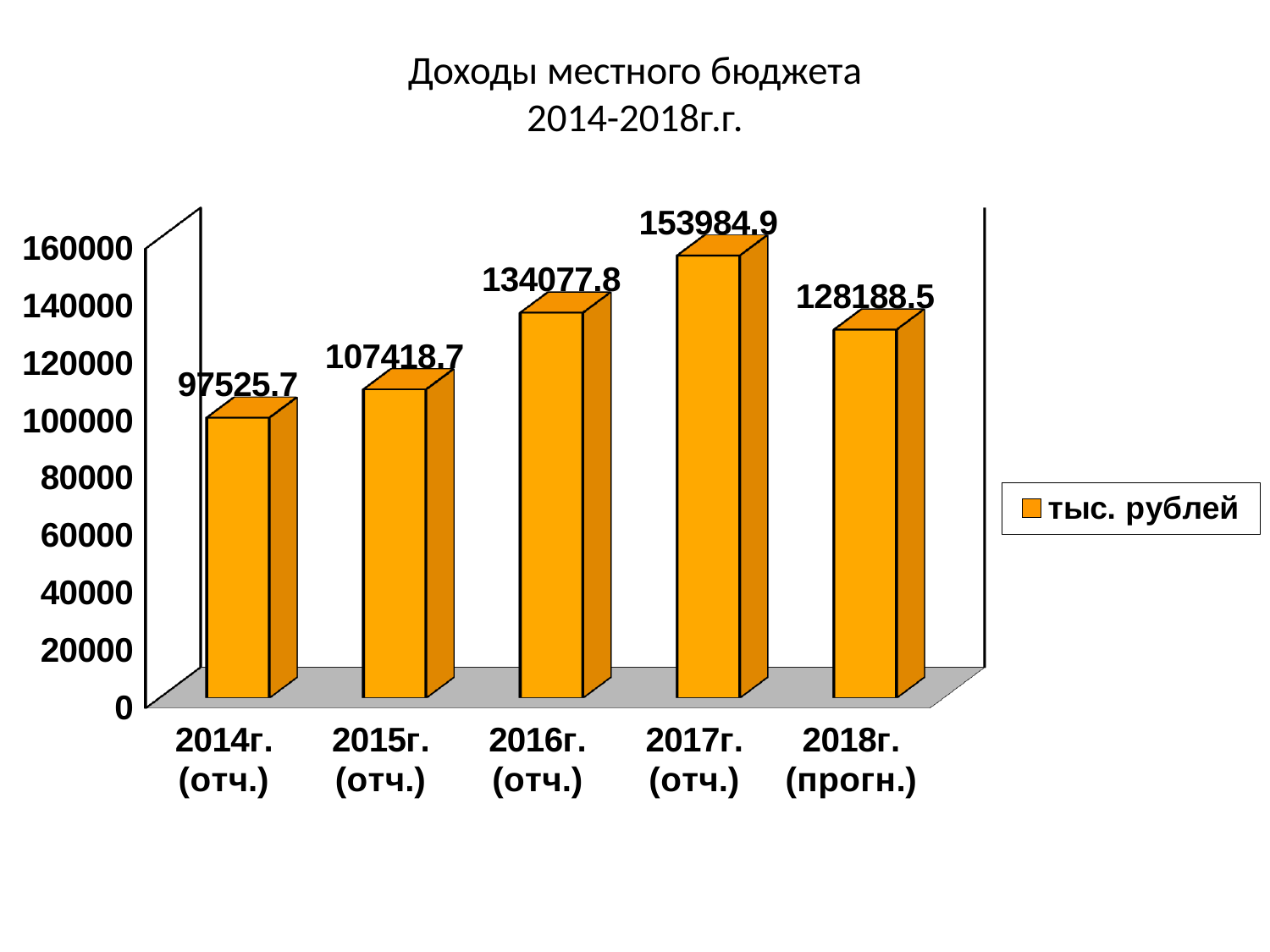
What is the difference between the values for 2017г. (отч.) and 2018г. (прогн.)? 25796.4 What kind of chart is shown on the slide? bar chart Which year has the lowest value? 2014г. (отч.) What is the value for 2017г. (отч.)? 153984.9 How many series does the legend list? 1 What is the value for 2014г. (отч.)? 97525.7 What is the value for 2018г. (прогн.)? 128188.5 What is the legend entry of the chart? тыс. рублей How many categories are shown on the x axis? 5 What is the difference between the values for 2015г. (отч.) and 2014г. (отч.)? 9893.0 Which year has the highest value? 2017г. (отч.) Which is larger, the value for 2016г. (отч.) or the value for 2018г. (прогн.)? 2016г. (отч.)